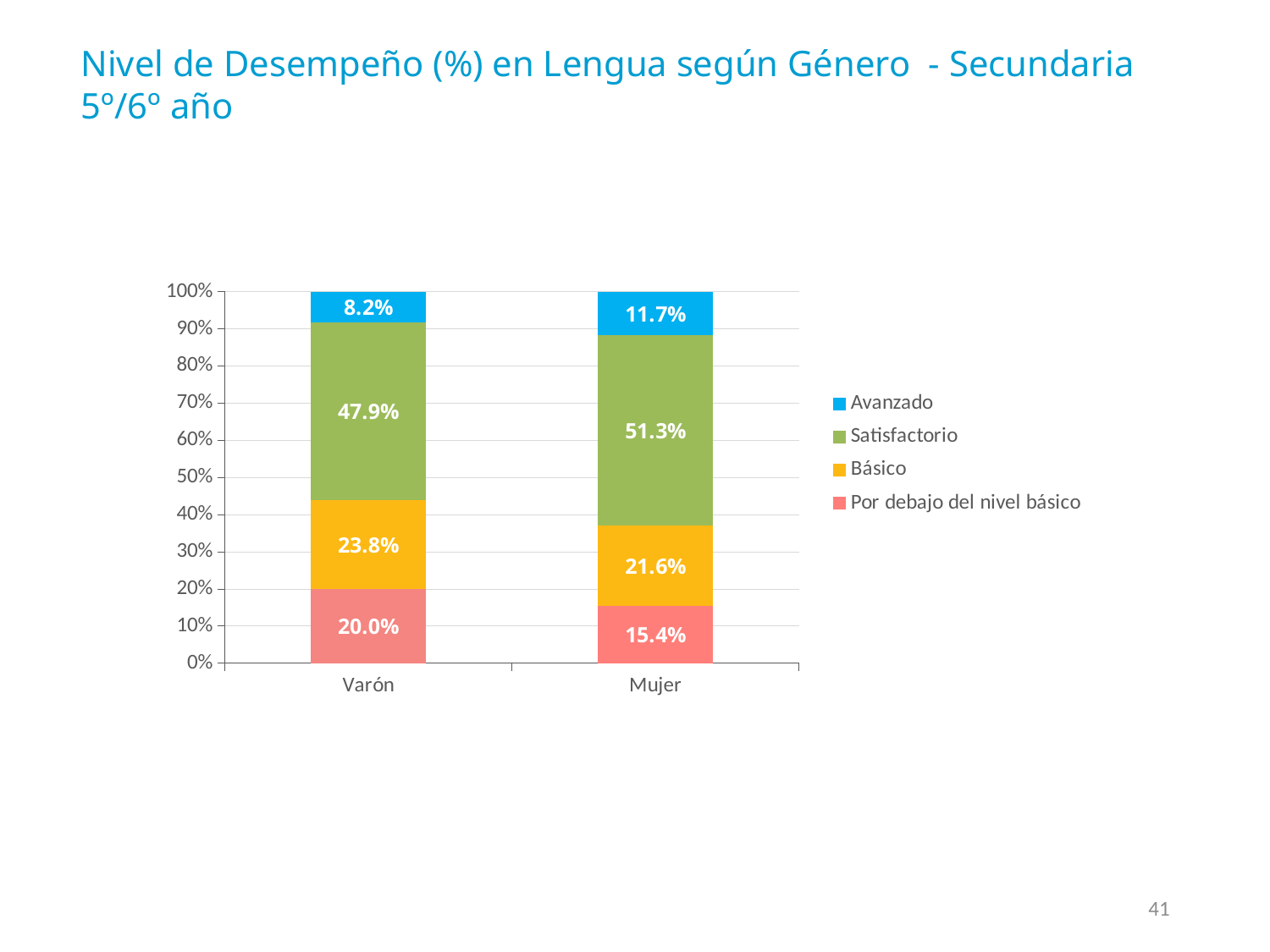
Which category has the higher Básico value, Varón or Mujer? Varón How many series does the legend list? 4 Which series has the smallest value for Mujer? Avanzado What is the difference between the Por debajo del nivel básico values for Varón and Mujer? 4.6% What is the Avanzado value for Varón? 8.2% Which category has the higher Avanzado value, Varón or Mujer? Mujer What kind of chart is shown on the slide? Stacked bar chart What is the Satisfactorio value for Mujer? 51.3% What is the difference between the Satisfactorio values for Mujer and Varón? 3.4% Which series has the largest value for Varón? Satisfactorio What is the Básico value for Varón? 23.8% What is the Por debajo del nivel básico value for Mujer? 15.4%